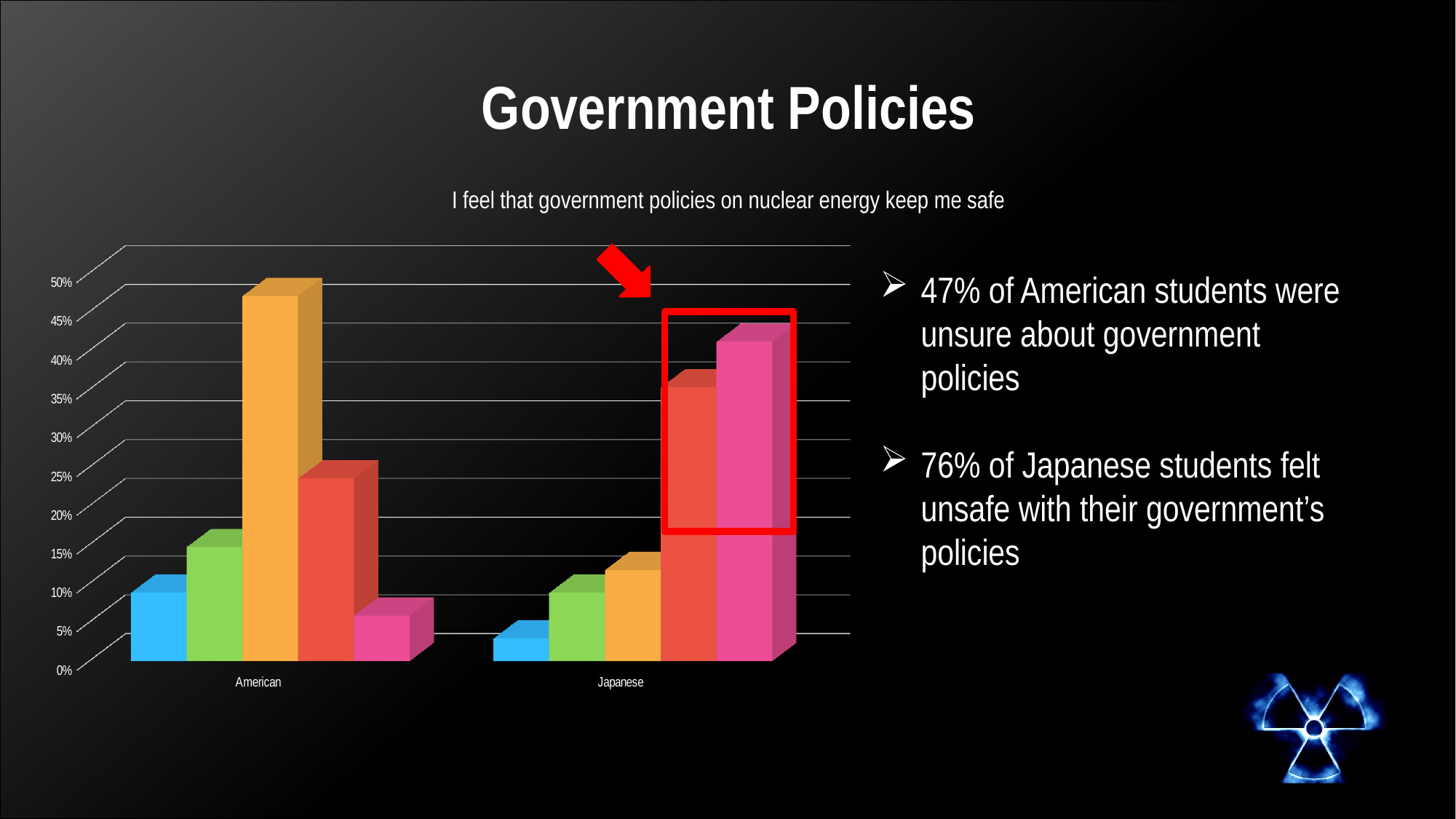
Which coloured bar is the tallest in the American category? orange What kind of chart is shown on the slide? bar chart What is the title of the chart? I feel that government policies on nuclear energy keep me safe Which coloured bar is the shortest in the Japanese category? blue How many bars are plotted for each category in the chart? 5 Is the value of the orange bar for American greater or less than 40%? greater Is the red bar larger for American or for Japanese? Japanese Is the value of the blue bar for Japanese greater or less than 5%? less Which coloured bar is the shortest in the American category? pink Is the value of the pink bar for Japanese greater or less than 35%? greater Which coloured bar is the tallest in the Japanese category? pink How many categories are shown on the x axis of the chart? 2